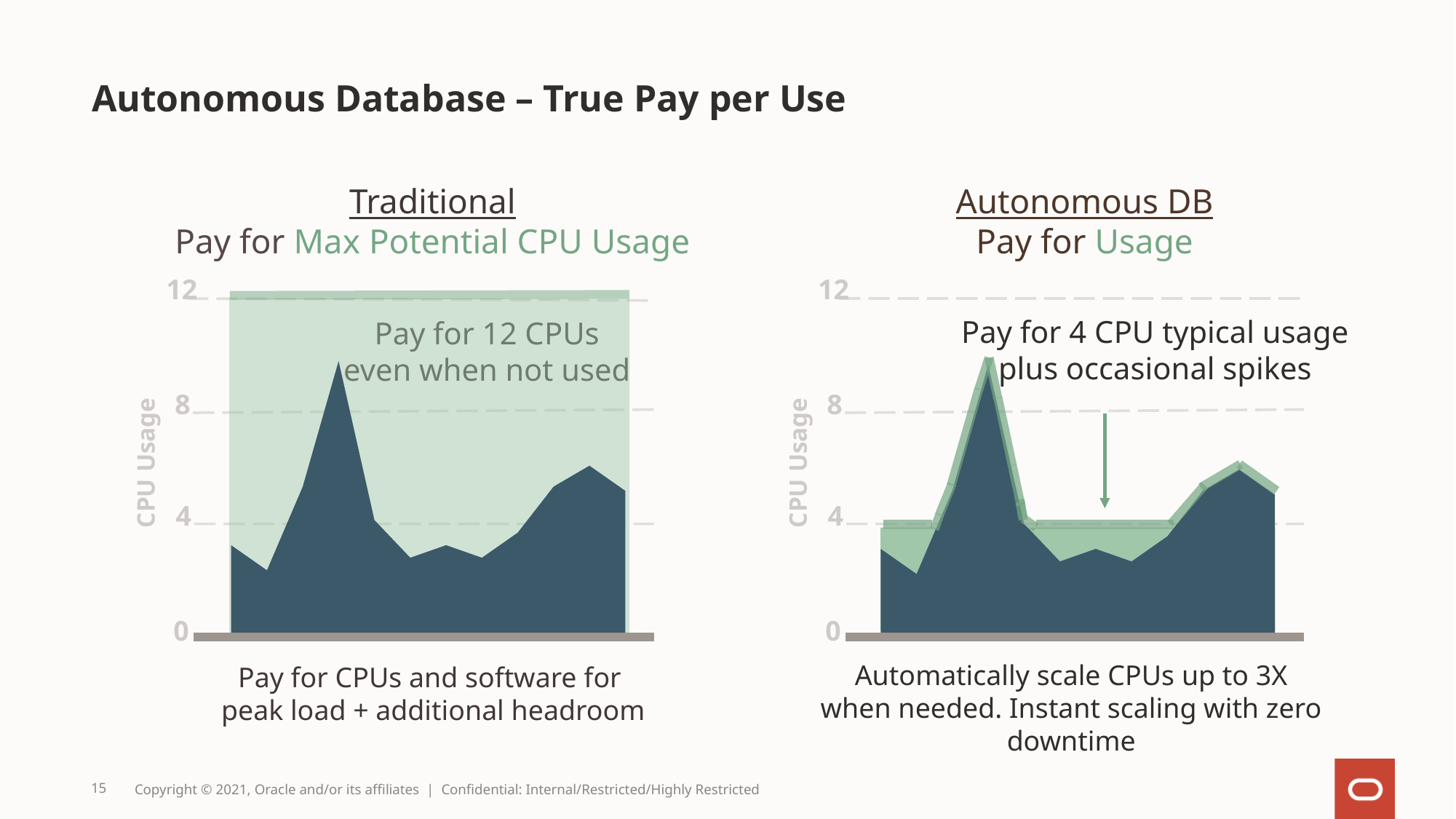
What is the y-axis title on the Traditional chart? CPU Usage In the Traditional chart, is the peak of the dark CPU usage area greater or less than 8? greater What is the highest tick value shown on the y-axis of the Autonomous DB chart? 12 In the Autonomous DB chart, is the peak of the CPU usage spike greater or less than 8? greater In the Autonomous DB chart, is the lowest point of the dark CPU usage area greater or less than 4? less What kind of chart is the Traditional chart on the left? area chart What kind of chart is the Autonomous DB chart on the right? area chart